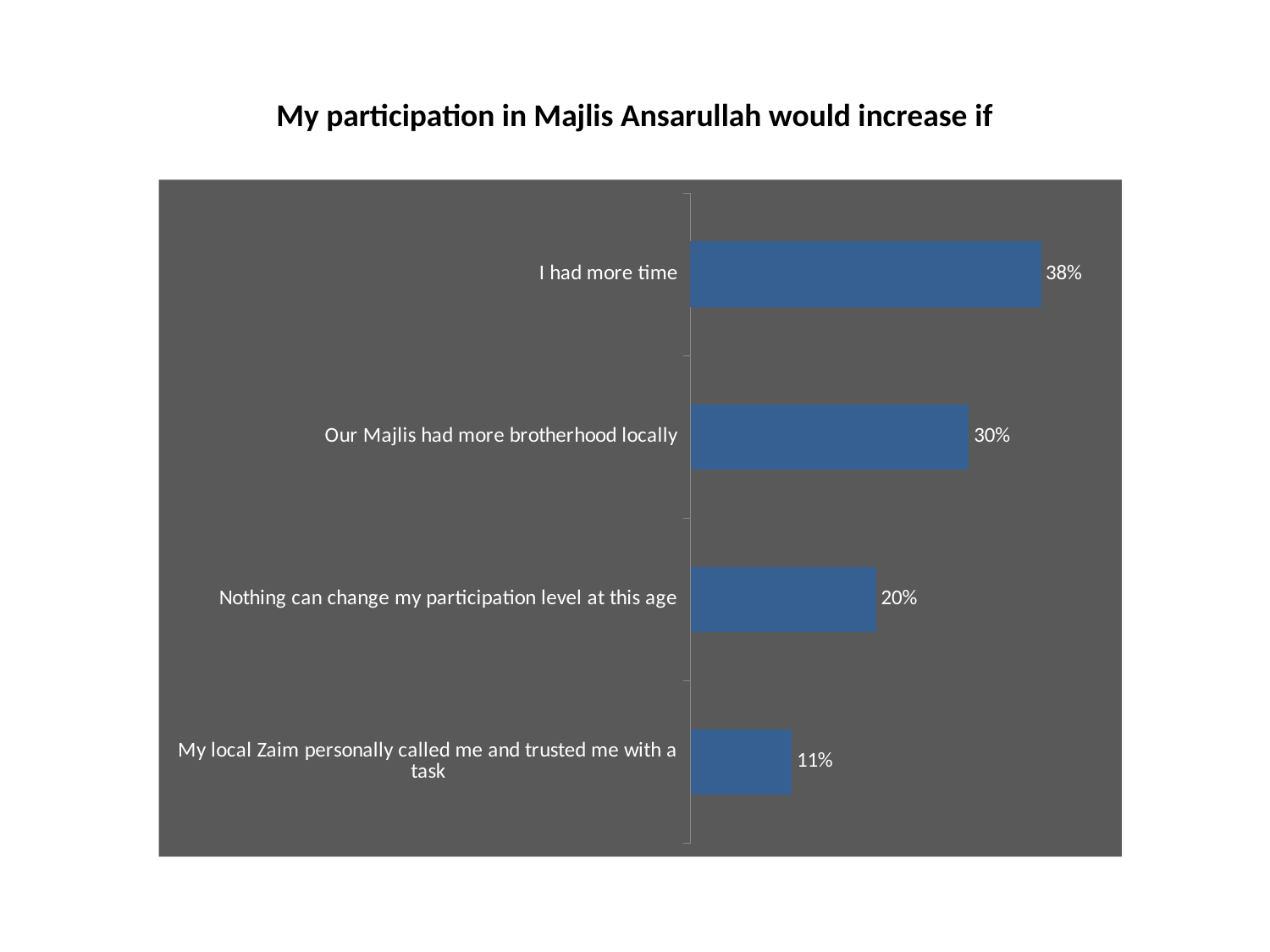
Which category has the lowest value? My local Zaim personally called me and trusted me with a task What is the difference between the values for "I had more time" and "Our Majlis had more brotherhood locally"? 8% Which category has the highest value? I had more time Which is larger: the value for "Our Majlis had more brotherhood locally" or for "Nothing can change my participation level at this age"? Our Majlis had more brotherhood locally What is the value for "I had more time"? 38% What kind of chart is shown on the slide? Bar chart What is the value for "Nothing can change my participation level at this age"? 20% How many categories are shown in the chart? 4 What is the difference between the values for "Nothing can change my participation level at this age" and "My local Zaim personally called me and trusted me with a task"? 9% What is the value for "Our Majlis had more brotherhood locally"? 30% What is the title of the chart? My participation in Majlis Ansarullah would increase if What is the value for "My local Zaim personally called me and trusted me with a task"? 11%